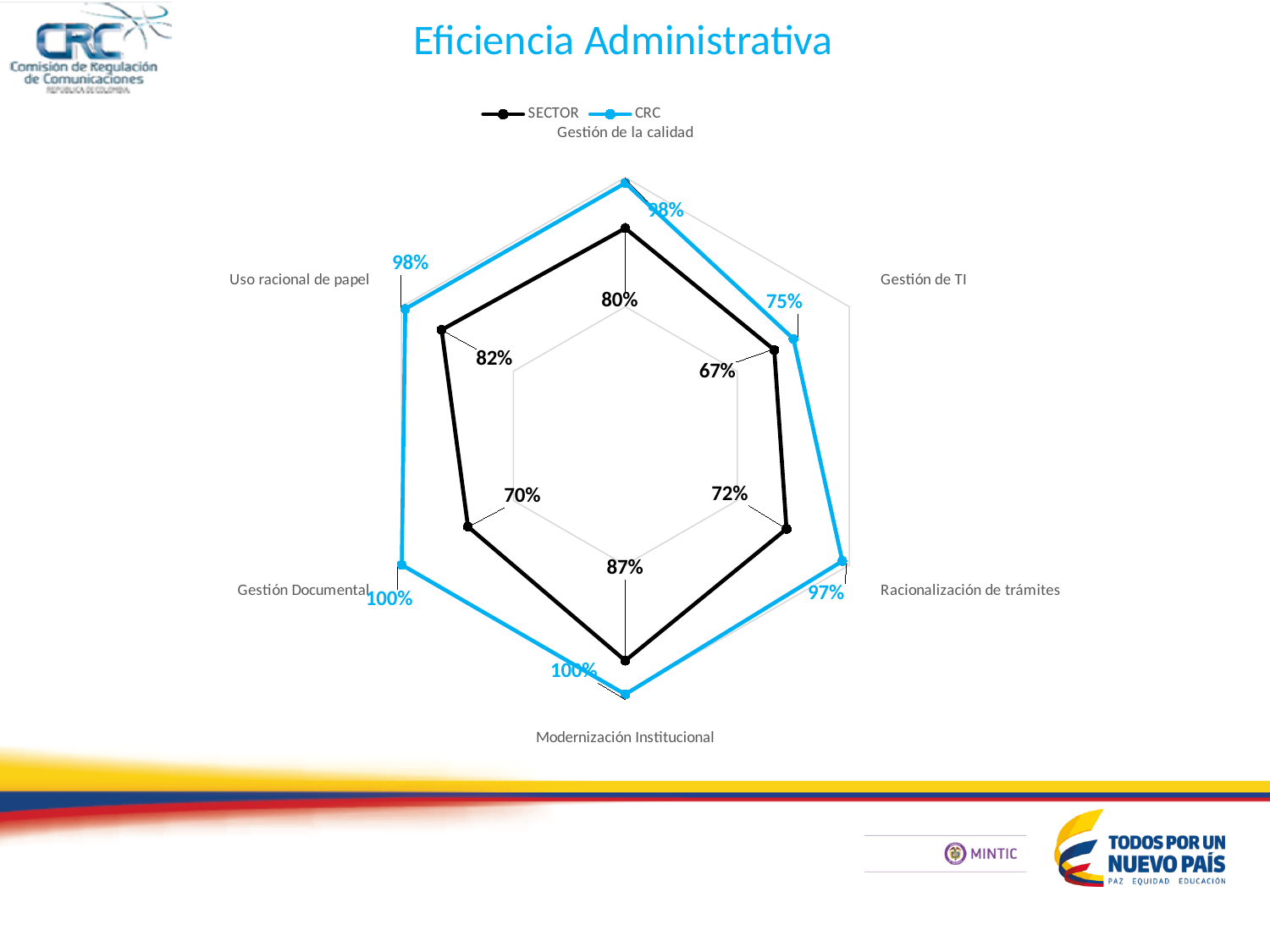
What is the title of the chart on the slide? Eficiencia Administrativa What kind of chart is shown on the slide? Radar chart Which category has the highest SECTOR value? Modernización Institucional What is the SECTOR value for Modernización Institucional? 87% Which is larger for Uso racional de papel, the CRC value or the SECTOR value? CRC What is the difference between the CRC and SECTOR values for Gestión Documental? 30% What is the SECTOR value for Gestión de TI? 67% How many categories are plotted on the radar chart? 6 What is the CRC value for Racionalización de trámites? 97% What is the CRC value for Gestión Documental? 100% Which category has the lowest SECTOR value? Gestión de TI How many series does the legend list? 2